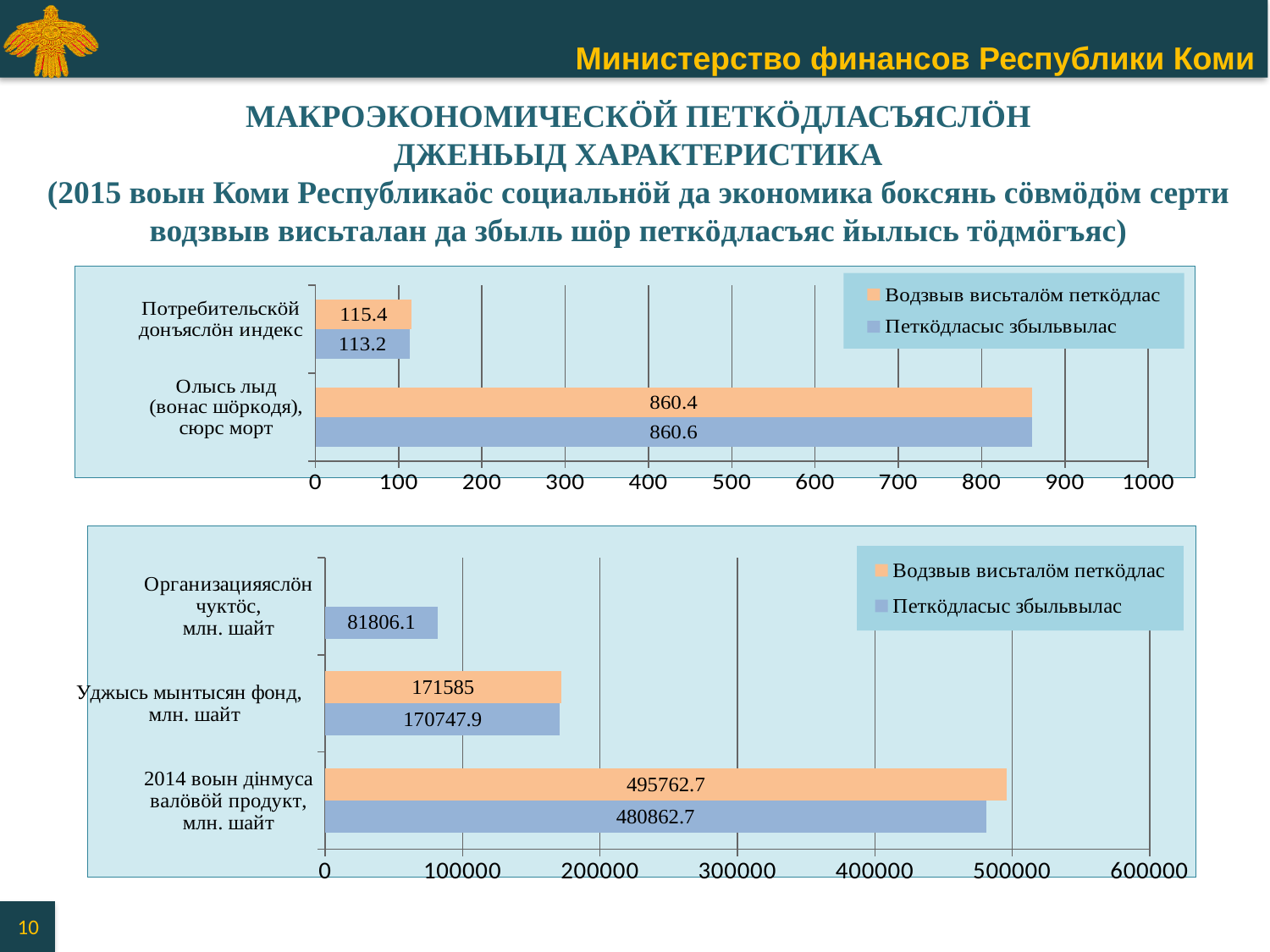
In the bottom chart, what is the value of 'Петкöдласыс збыльвылас' for '2014 воын дінмуса валöвöй продукт, млн. шайт'? 480862.7 What kind of chart is the top chart? Bar chart In the bottom chart, which category has the highest 'Водзвыв висьталöм петкöдлас' value? 2014 воын дінмуса валöвöй продукт, млн. шайт In the bottom chart, what is the value of 'Петкöдласыс збыльвылас' for 'Организацияяслöн чуктöс, млн. шайт'? 81806.1 In the bottom chart, how many categories are shown on the vertical axis? 3 In the top chart, how many series does the legend list? 2 In the top chart, what is the difference between the two values shown for 'Потребительскöй донъяслöн индекс'? 2.2 In the bottom chart, what is the value of 'Водзвыв висьталöм петкöдлас' for 'Уджысь мынтысян фонд, млн. шайт'? 171585 In the bottom chart, which colour represents 'Петкöдласыс збыльвылас'? Blue In the top chart, what is the value of 'Петкöдласыс збыльвылас' for 'Олысь лыд (вонас шöркодя), сюрс морт'? 860.6 In the top chart, what is the value of 'Водзвыв висьталöм петкöдлас' for 'Потребительскöй донъяслöн индекс'? 115.4 In the bottom chart, what is the difference between 'Водзвыв висьталöм петкöдлас' and 'Петкöдласыс збыльвылас' for '2014 воын дінмуса валöвöй продукт, млн. шайт'? 14900